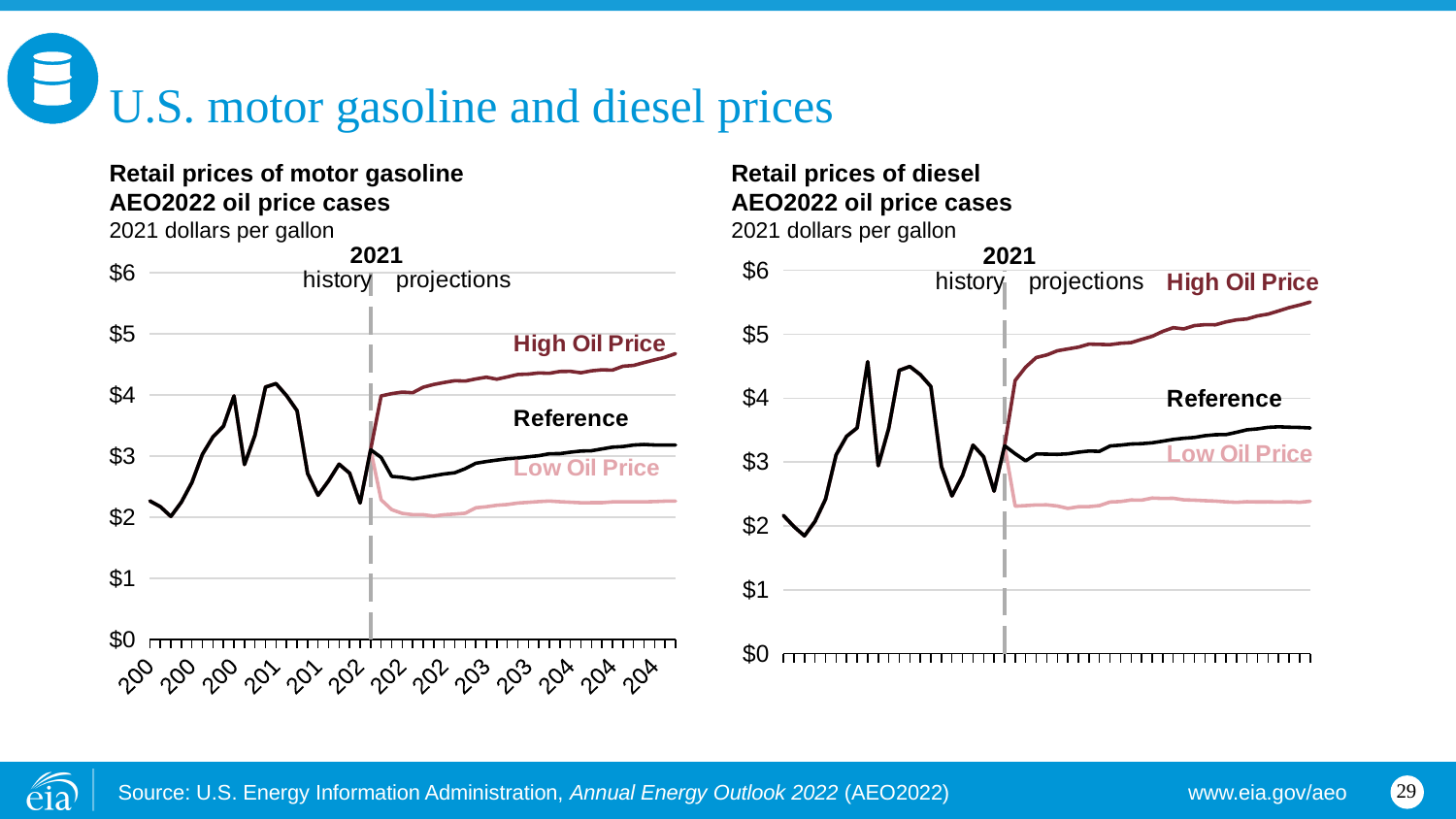
How many price-case series are plotted on the 'Retail prices of diesel' chart? 3 On the 'Retail prices of motor gasoline' chart, which series is highest during the projection period? High Oil Price On the 'Retail prices of motor gasoline' chart, does the High Oil Price series rise or fall over the projection period? rise On the 'Retail prices of diesel' chart, which is larger at the end of the projection period, the High Oil Price series or the Reference series? High Oil Price On the 'Retail prices of diesel' chart, is the Reference value at the end of the projection period greater or less than $3? greater On the 'Retail prices of diesel' chart, which series is lowest during the projection period? Low Oil Price What type of chart is the 'Retail prices of motor gasoline' chart? line chart What unit are prices expressed in on the 'Retail prices of diesel' chart? 2021 dollars per gallon On the 'Retail prices of diesel' chart, is the High Oil Price value at the end of the projection period greater or less than $5? greater What year does the dashed vertical line separating history from projections mark on the 'Retail prices of motor gasoline' chart? 2021 On the 'Retail prices of motor gasoline' chart, is the Low Oil Price value at the end of the projection period greater or less than $3? less